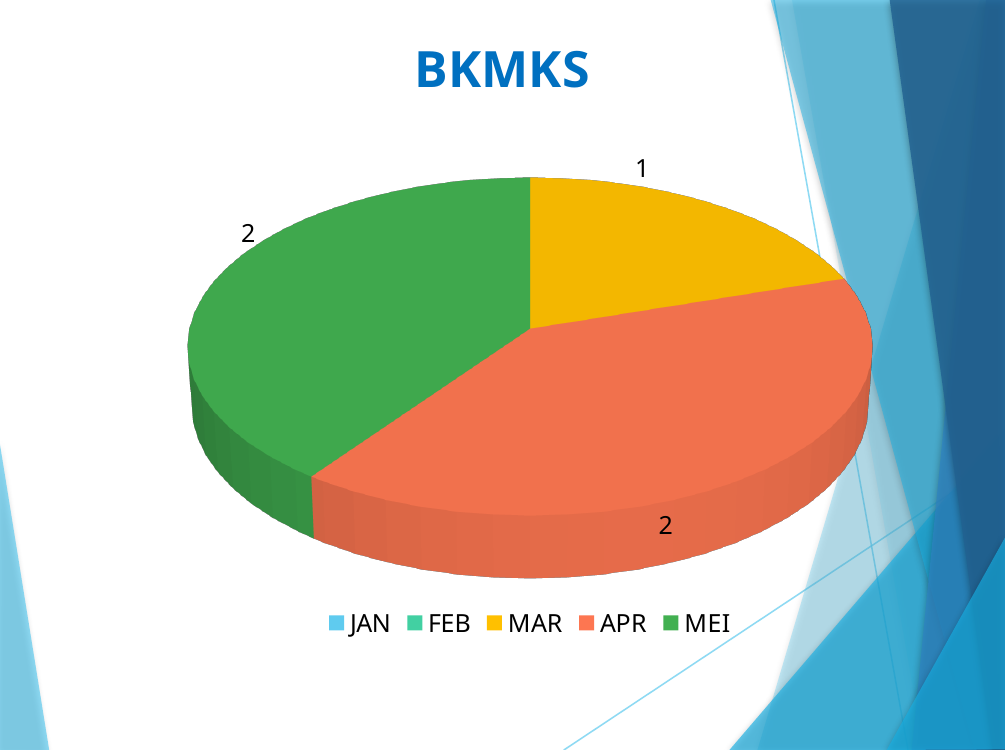
How many slices are visible in the pie? 3 What is the value of the APR slice? 2 Which slice has the smallest value in the pie? MAR Which is larger, the APR slice or the MAR slice? APR What share of the pie does the MAR slice represent? 20% What is the difference between the APR value and the MAR value? 1 What is the value of the MAR slice? 1 How many entries does the chart's legend list? 5 What is the value of the MEI slice? 2 What kind of chart is shown on the slide? pie chart What is the title of the chart? BKMKS What colour is the APR slice? orange